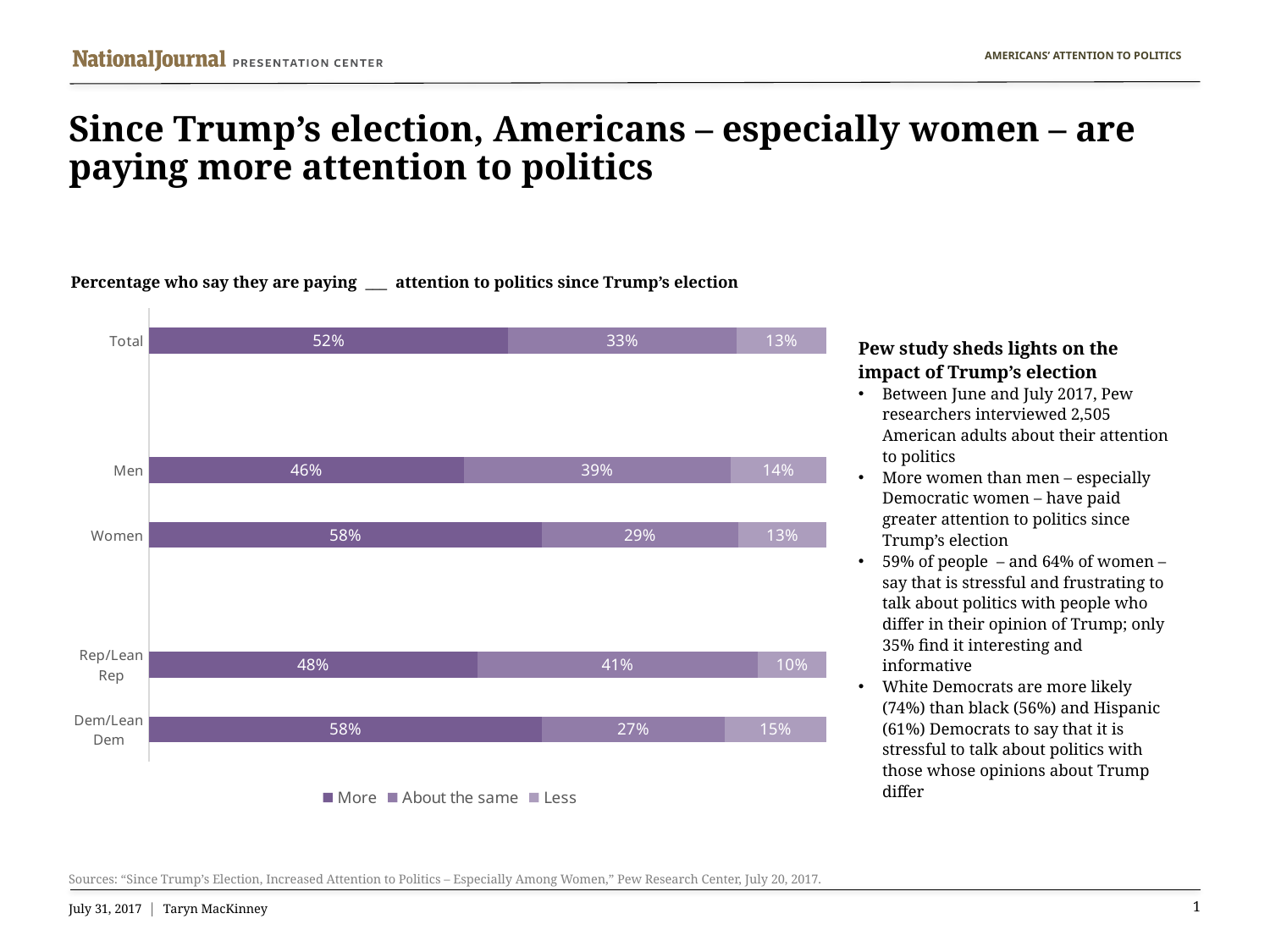
What kind of chart is shown on the slide? Stacked bar chart How many series does the legend list? 3 Which is larger, the 'About the same' value for Rep/Lean Rep or for Dem/Lean Dem? Rep/Lean Rep Which category has the highest 'Less' percentage? Dem/Lean Dem What is the difference between the 'More' percentages for Women and Men? 12 percentage points What percentage of Rep/Lean Rep say they are paying less attention to politics? 10% What are the three legend entries on the chart? More, About the same, Less Which category has the lowest 'More' percentage? Men What is the 'More' value for the Total category? 52% What percentage of Women say they are paying more attention to politics since Trump's election? 58% How many categories are shown on the chart? 5 What percentage of Men say they are paying about the same attention to politics? 39%